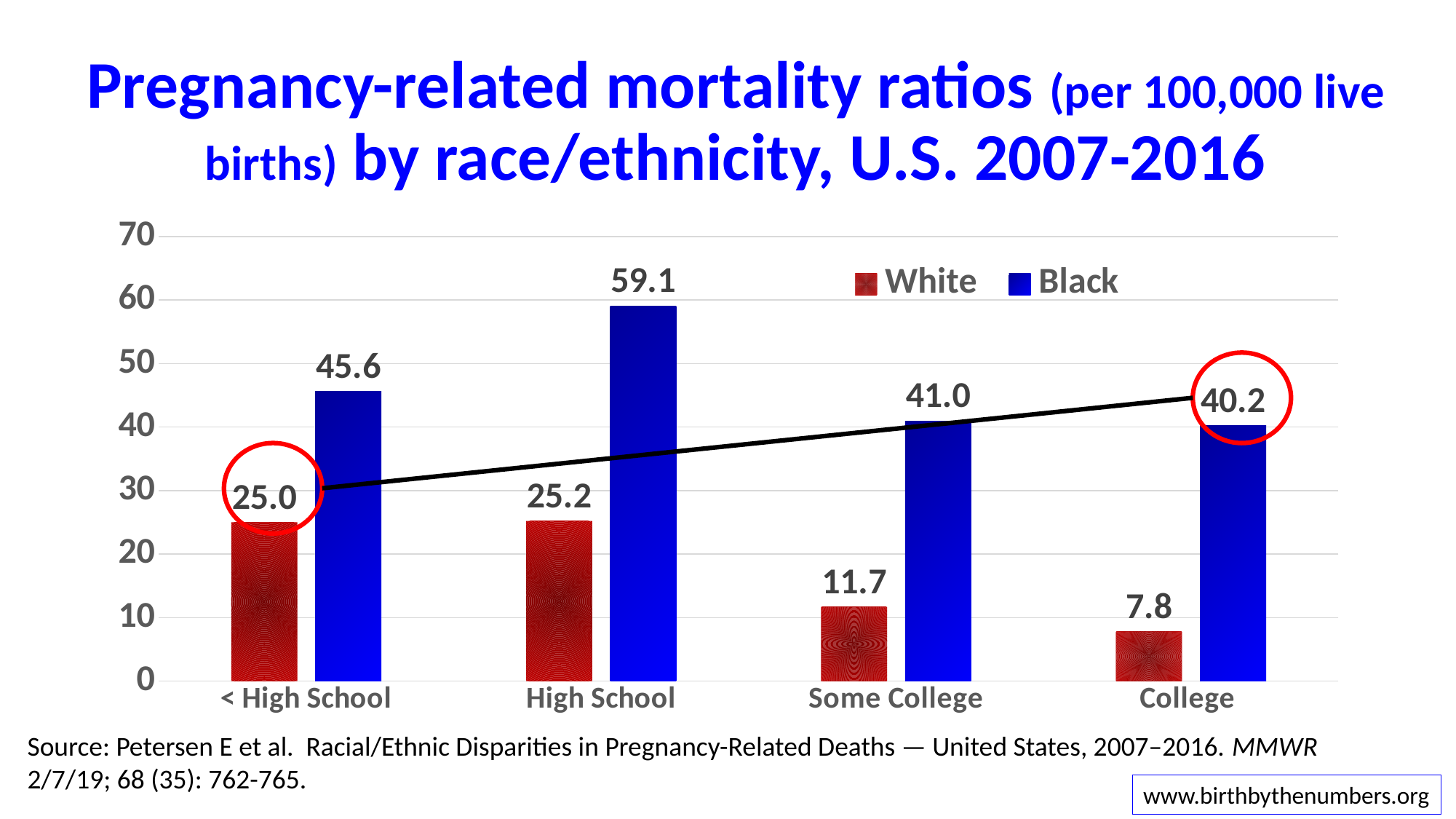
Which is larger: the White value for < High School or the White value for High School? High School What is the value for White women in the Some College category? 11.7 Which education category has the highest value for Black women? High School What is the pregnancy-related mortality ratio for Black women with a High School education? 59.1 How many education categories are shown on the x axis? 4 How many series does the legend list? 2 Which education category has the lowest value for White women? College What kind of chart is shown on the slide? Bar chart What is the difference between the Black and White values in the College category? 32.4 What is the pregnancy-related mortality ratio for White women with a College education? 7.8 What is the difference between the Black values for High School and Some College? 18.1 Which colour represents the Black series in the chart? Blue